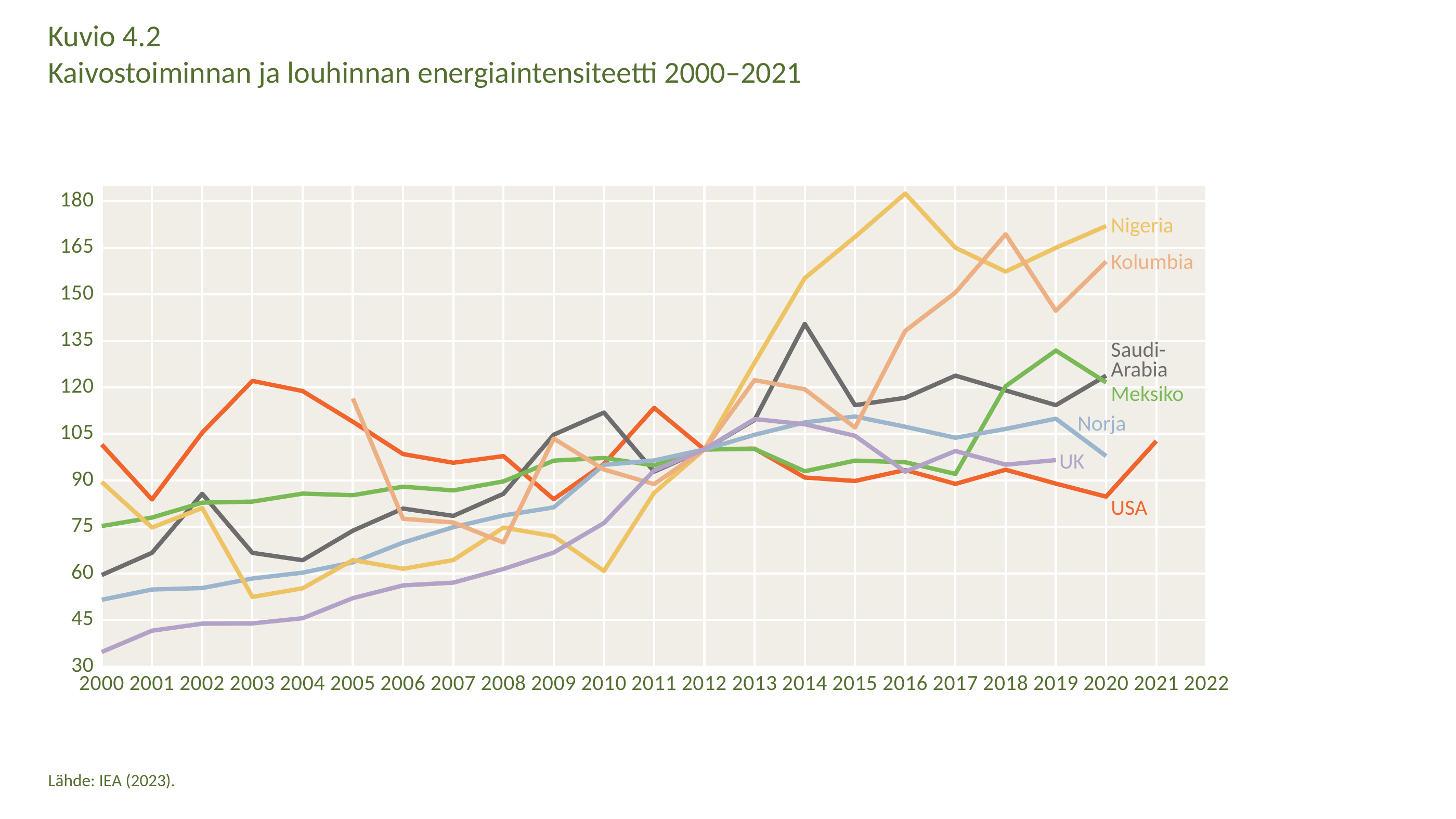
Which country has the highest value in 2016? Nigeria Is the value for Kolumbia in 2019 greater or less than 135? greater What is the title of the chart? Kaivostoiminnan ja louhinnan energiaintensiteetti 2000–2021 Which country has the lowest value in 2020? USA In 2010, which is larger: the value for Saudi-Arabia or the value for Nigeria? Saudi-Arabia How many countries (series) are plotted in the chart? 7 Which country has the lowest value in 2000? UK Is the value for Norja in 2000 greater or less than 60? less Is the value for Nigeria in 2016 greater or less than 165? greater Does the UK line rise or fall from 2000 to 2013? rise What kind of chart is shown on the slide? line chart